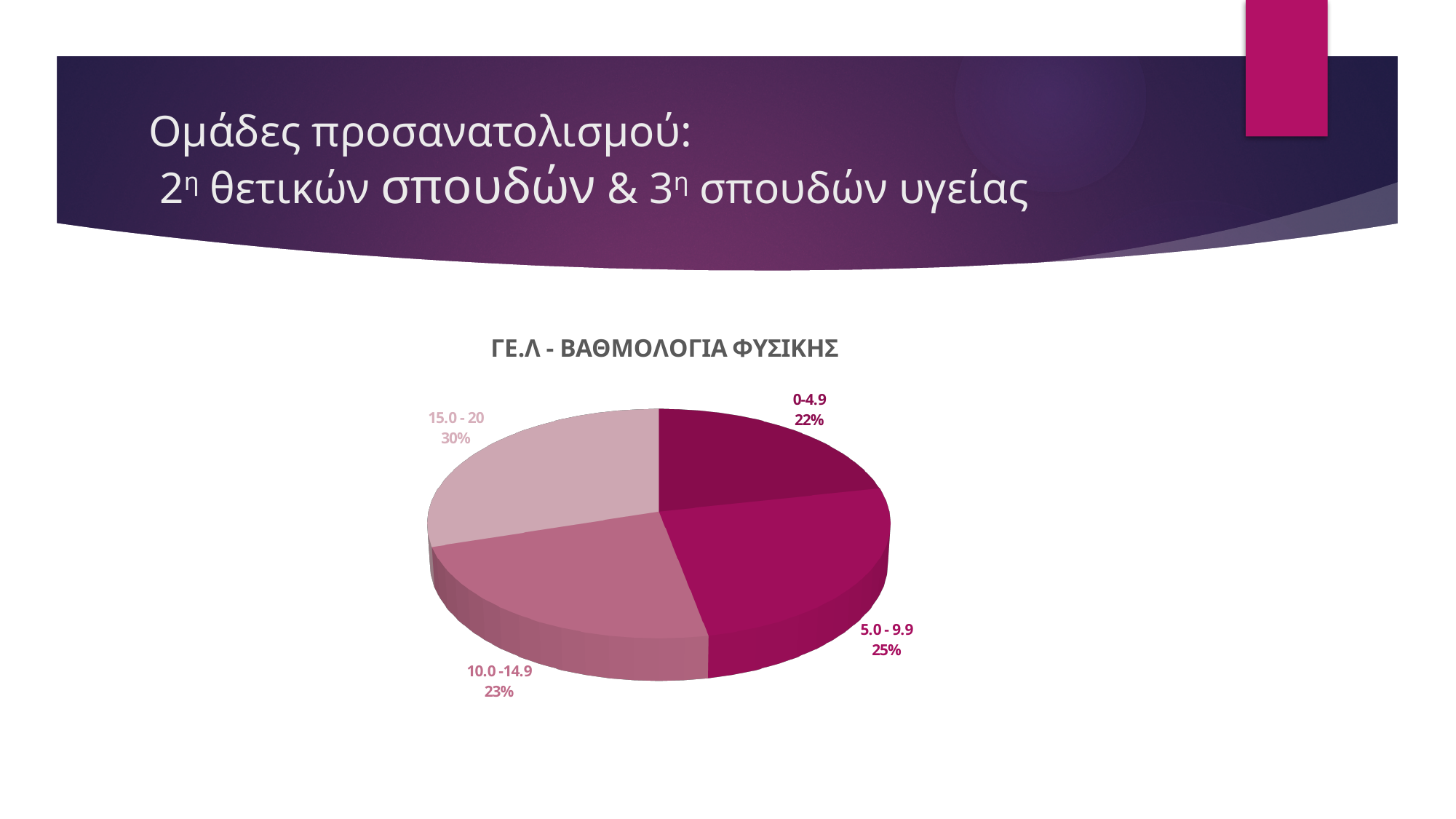
What percentage of the pie does the 10.0 -14.9 slice represent? 23% What type of chart is shown on the slide? Pie chart What percentage of the pie does the 15.0 - 20 slice represent? 30% Which grade range has the largest share of the pie? 15.0 - 20 How many slices does the pie chart have? 4 Which slice is larger, 5.0 - 9.9 or 10.0 -14.9? 5.0 - 9.9 What is the title of the chart? ΓΕ.Λ - ΒΑΘΜΟΛΟΓΙΑ ΦΥΣΙΚΗΣ What percentage of the pie does the 0-4.9 slice represent? 22% Which grade range has the smallest share of the pie? 0-4.9 What is the difference in percentage points between the 15.0 - 20 slice and the 0-4.9 slice? 8 What percentage of the pie does the 5.0 - 9.9 slice represent? 25% What is the combined share of the 0-4.9 and 5.0 - 9.9 slices? 47%